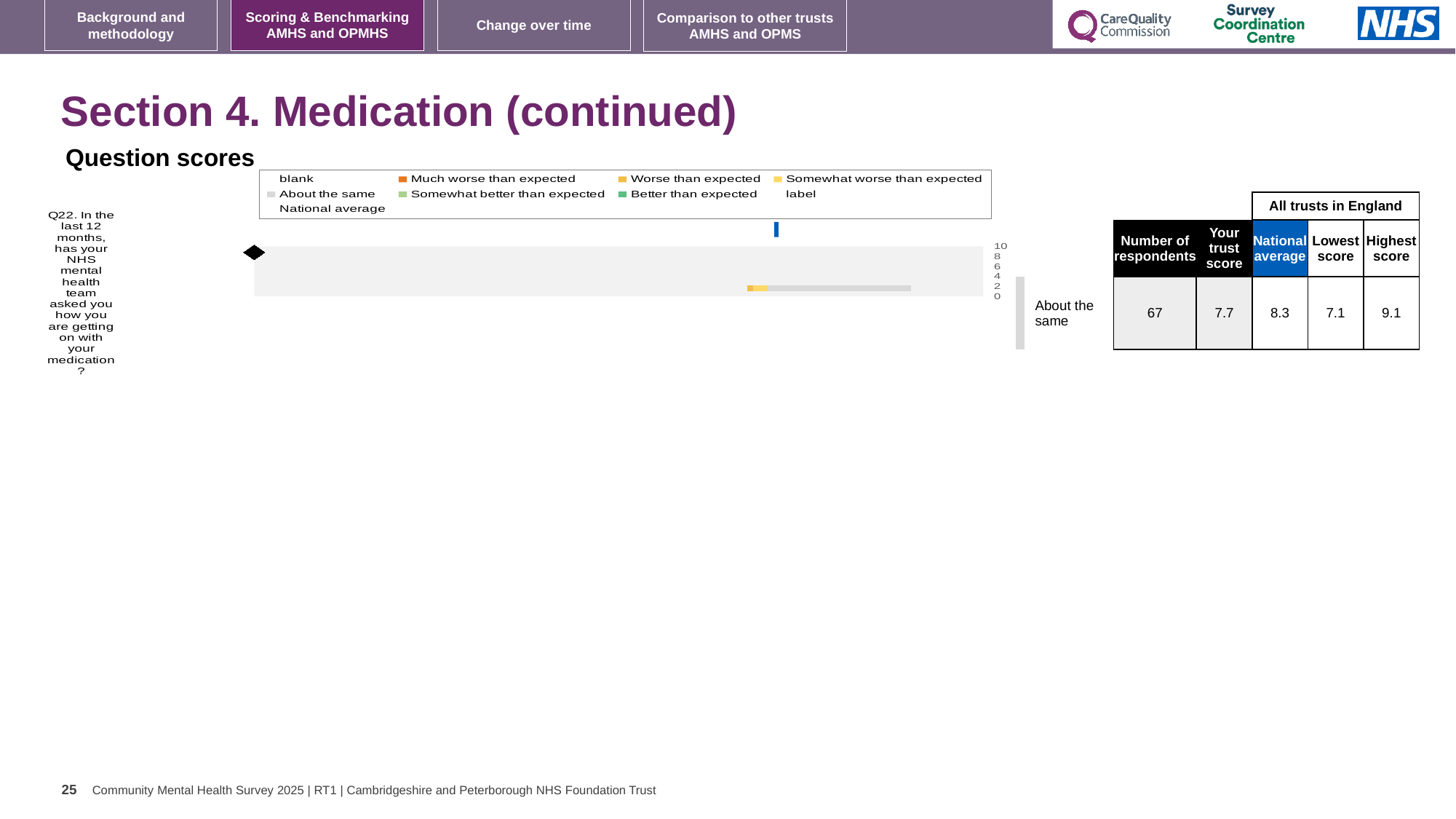
What is the trust's score for Q22? 7.7 How much higher is the national average than the trust's score for Q22? 0.6 What kind of chart is shown under 'Question scores'? bar chart For Q22, which is larger: the trust's score or the national average? National average How many entries does the legend of the Question scores chart list? 9 What is the national average score for Q22? 8.3 How many survey questions are plotted in the Question scores chart? 1 What is the lowest score among all trusts in England for Q22? 7.1 What is the number of respondents for Q22? 67 What comparison category is shown next to the Q22 bar? About the same What is the difference between the highest and lowest trust scores for Q22? 2.0 What is the highest score among all trusts in England for Q22? 9.1